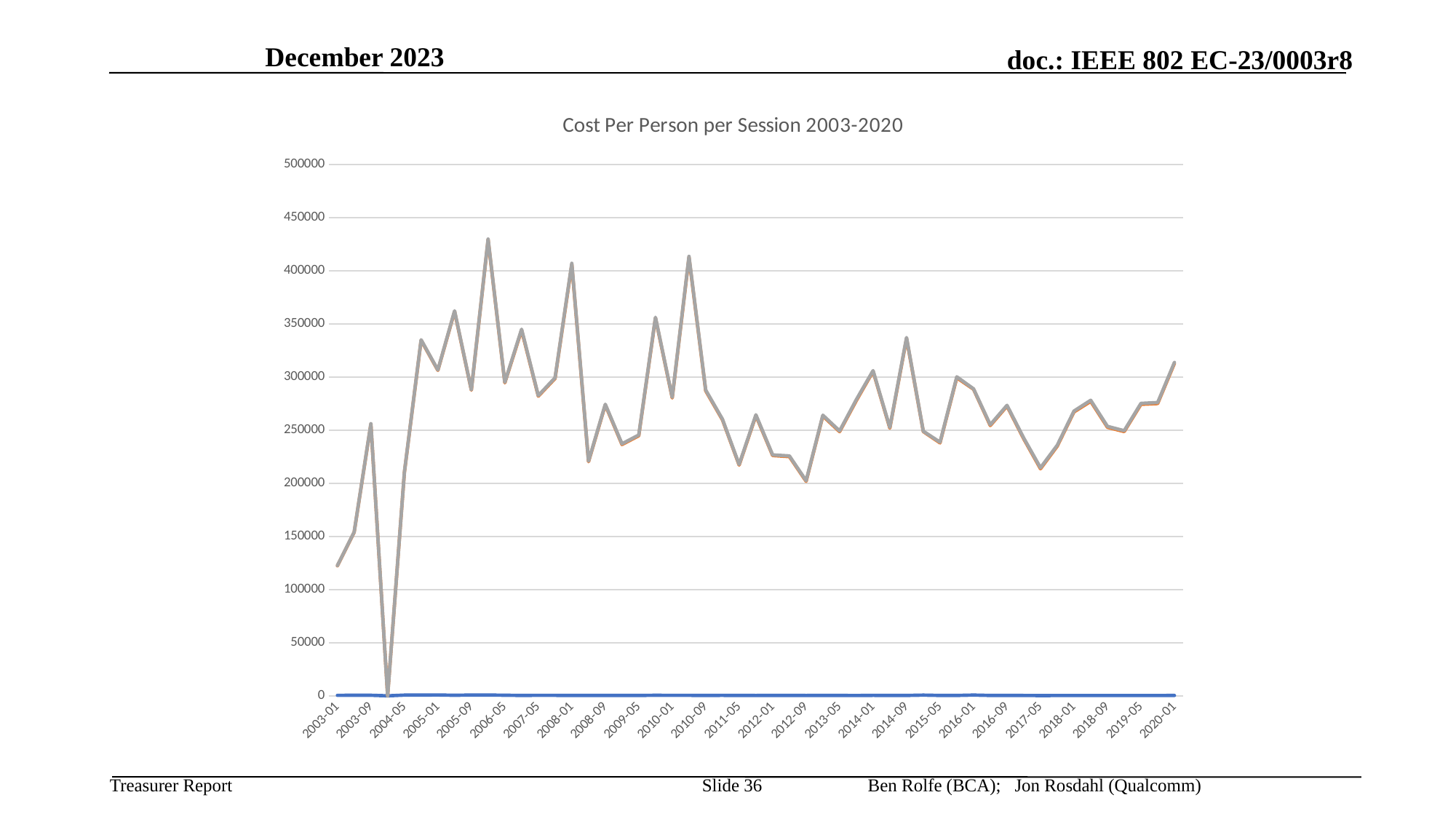
Does the value rise or fall from 2003-01 to 2003-09? rise Is the value for 2020-01 greater or less than 300000? greater Is the value for 2008-01 greater or less than 350000? greater Is the value for 2003-01 greater or less than 150000? less Which has the larger value, 2012-09 or 2014-09? 2014-09 Which has the larger value, 2003-01 or 2020-01? 2020-01 What is the title of the chart? Cost Per Person per Session 2003-2020 What kind of chart is shown on the slide? line chart What is the highest value shown on the vertical axis? 500000